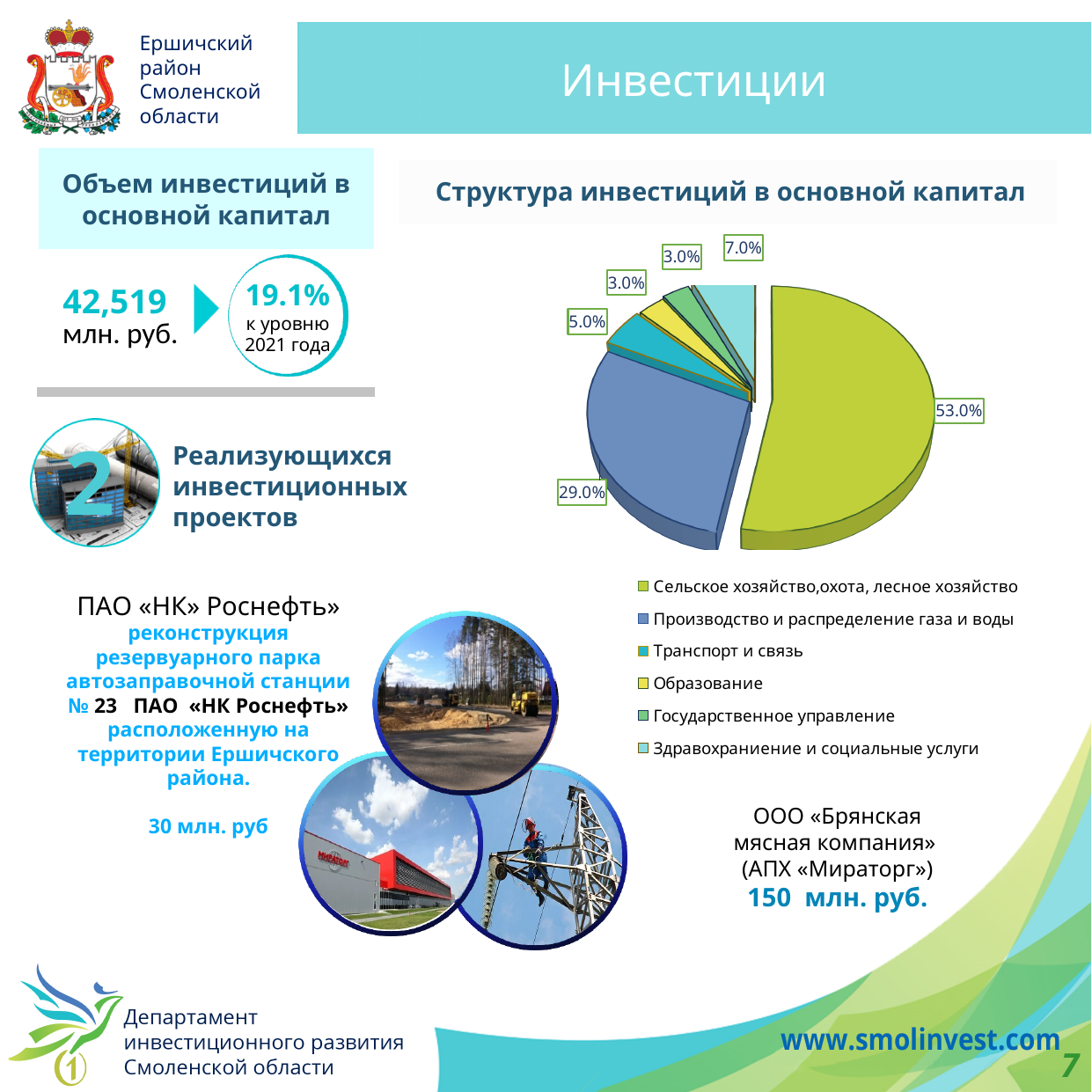
Which category has the largest slice in the pie chart «Структура инвестиций в основной капитал»? Сельское хозяйство, охота, лесное хозяйство In the pie chart, what share is «Образование»? 3.0% In the pie chart, which is larger: «Здравоохранение и социальные услуги» or «Транспорт и связь»? Здравоохранение и социальные услуги In the pie chart «Структура инвестиций в основной капитал», what share is «Сельское хозяйство, охота, лесное хозяйство»? 53.0% In the pie chart, what share is «Производство и распределение газа и воды»? 29.0% In the pie chart, what is the difference between the shares of «Сельское хозяйство, охота, лесное хозяйство» and «Производство и распределение газа и воды»? 24.0% What is the title of the pie chart on the slide? Структура инвестиций в основной капитал In the pie chart, what share is «Здравоохранение и социальные услуги»? 7.0% How many categories does the legend of the pie chart list? 6 In the pie chart, what share is «Транспорт и связь»? 5.0% What kind of chart is used for «Структура инвестиций в основной капитал»? pie chart In the pie chart, what is the combined share of «Образование» and «Государственное управление»? 6.0%